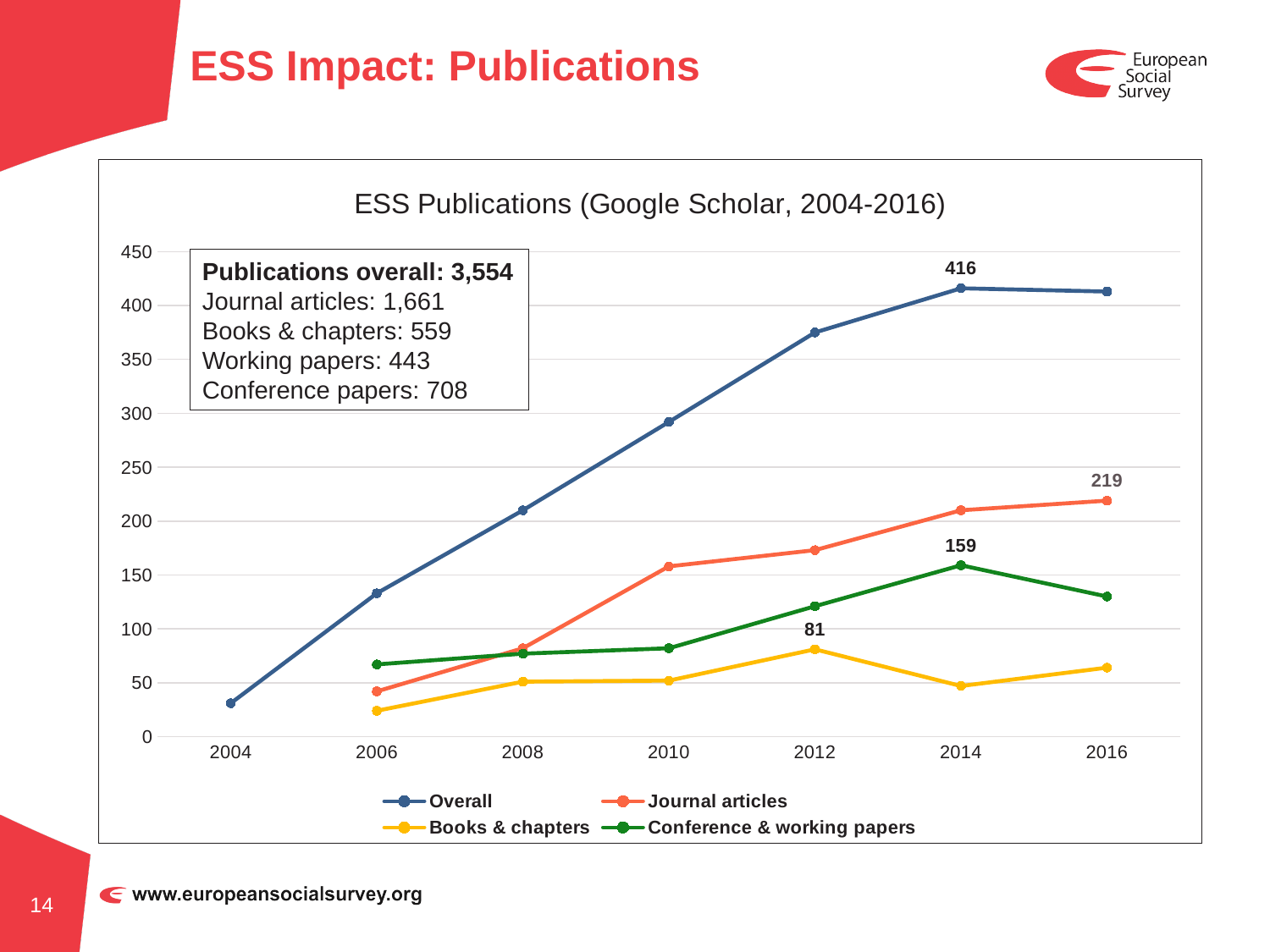
What is the title of the chart? ESS Publications (Google Scholar, 2004-2016) How many series does the legend list? 4 How many years are shown on the x axis? 7 Which is larger: the Overall value in 2014 or the Journal articles value in 2016? Overall in 2014 Is the value for Overall in 2010 greater or less than 250? greater What is the difference between the Overall value and the Conference & working papers value in 2014? 257 What is the value for Overall in 2014? 416 What is the value for Books & chapters in 2012? 81 Does the Overall series rise or fall from 2004 to 2014? rise What kind of chart is shown on the slide? line chart What is the value for Journal articles in 2016? 219 What is the value for Conference & working papers in 2014? 159